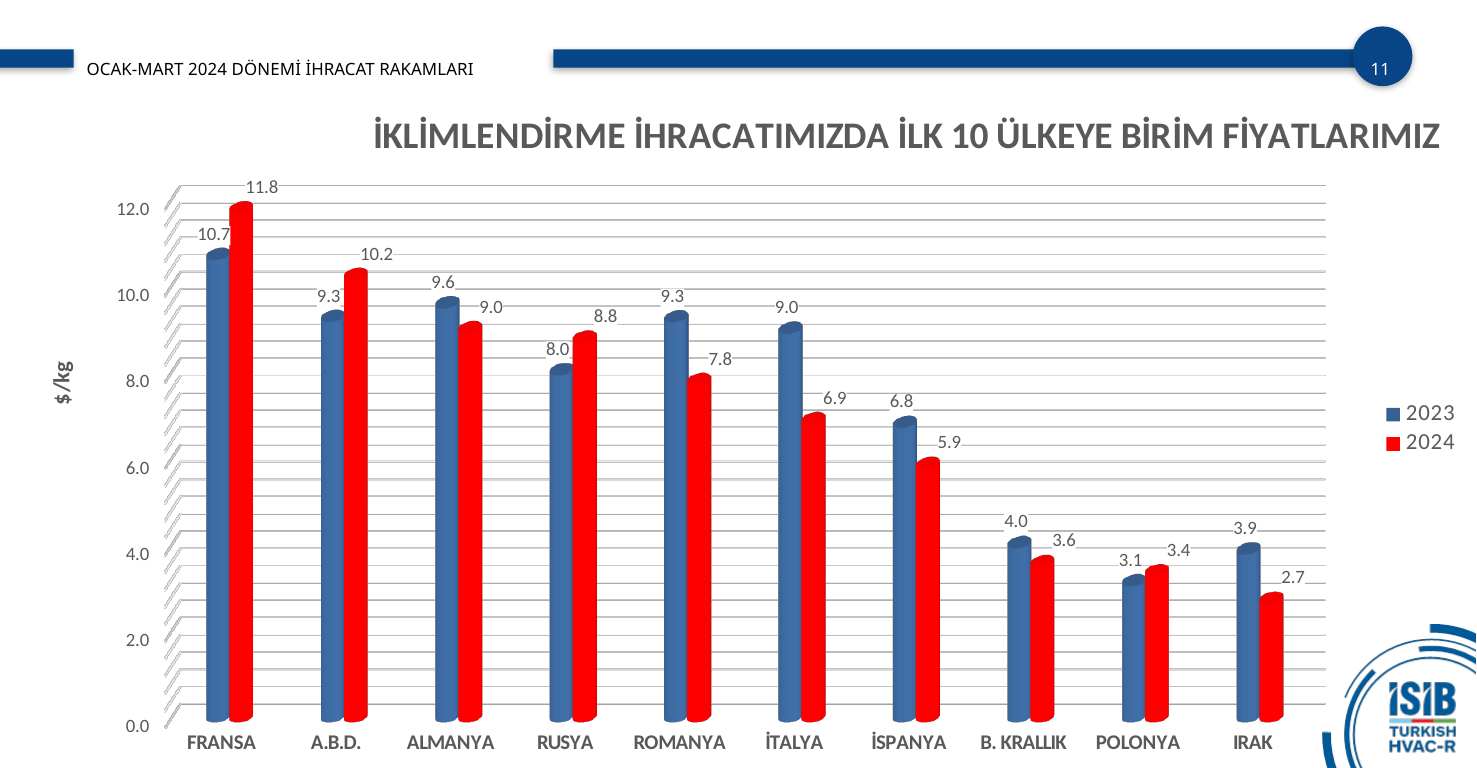
Is the 2024 value for İSPANYA greater or less than 6.0? less What is the difference between the 2023 and 2024 values for İTALYA? 2.1 What is the 2023 unit price for ROMANYA? 9.3 How many countries are shown on the x axis? 10 Which country has the lowest 2023 value? POLONYA What is the 2024 unit price for FRANSA? 11.8 What is the 2024 value for POLONYA? 3.4 How many series does the legend list? 2 Which country has the highest 2024 value? FRANSA For ALMANYA, which year has the larger value, 2023 or 2024? 2023 What kind of chart is shown on the slide? bar chart What is the label on the vertical axis? $/kg